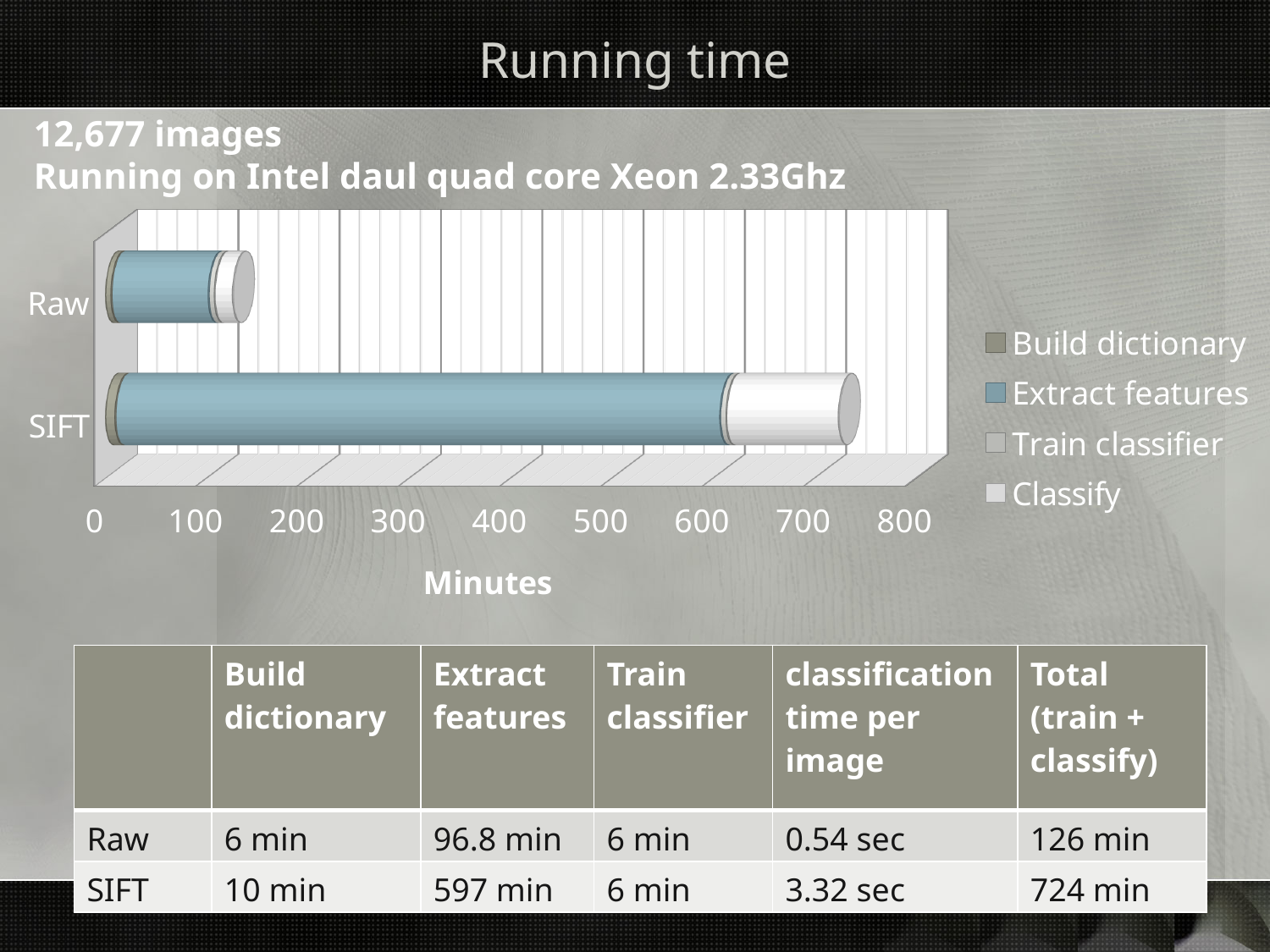
Which legend entry is listed first? Build dictionary Is the total bar length for Raw greater or less than 100 minutes? greater Is the total bar length for Raw greater or less than 200 minutes? less How many series does the chart legend list? 4 Is the Extract features segment for SIFT larger than the Extract features segment for Raw? Yes Is the total bar length for SIFT greater or less than 600 minutes? greater Which category has the longer total bar, Raw or SIFT? SIFT Which category has the shorter total bar? Raw How many categories are plotted on the chart? 2 What kind of chart is shown on the slide? bar chart What is the title of the horizontal axis? Minutes